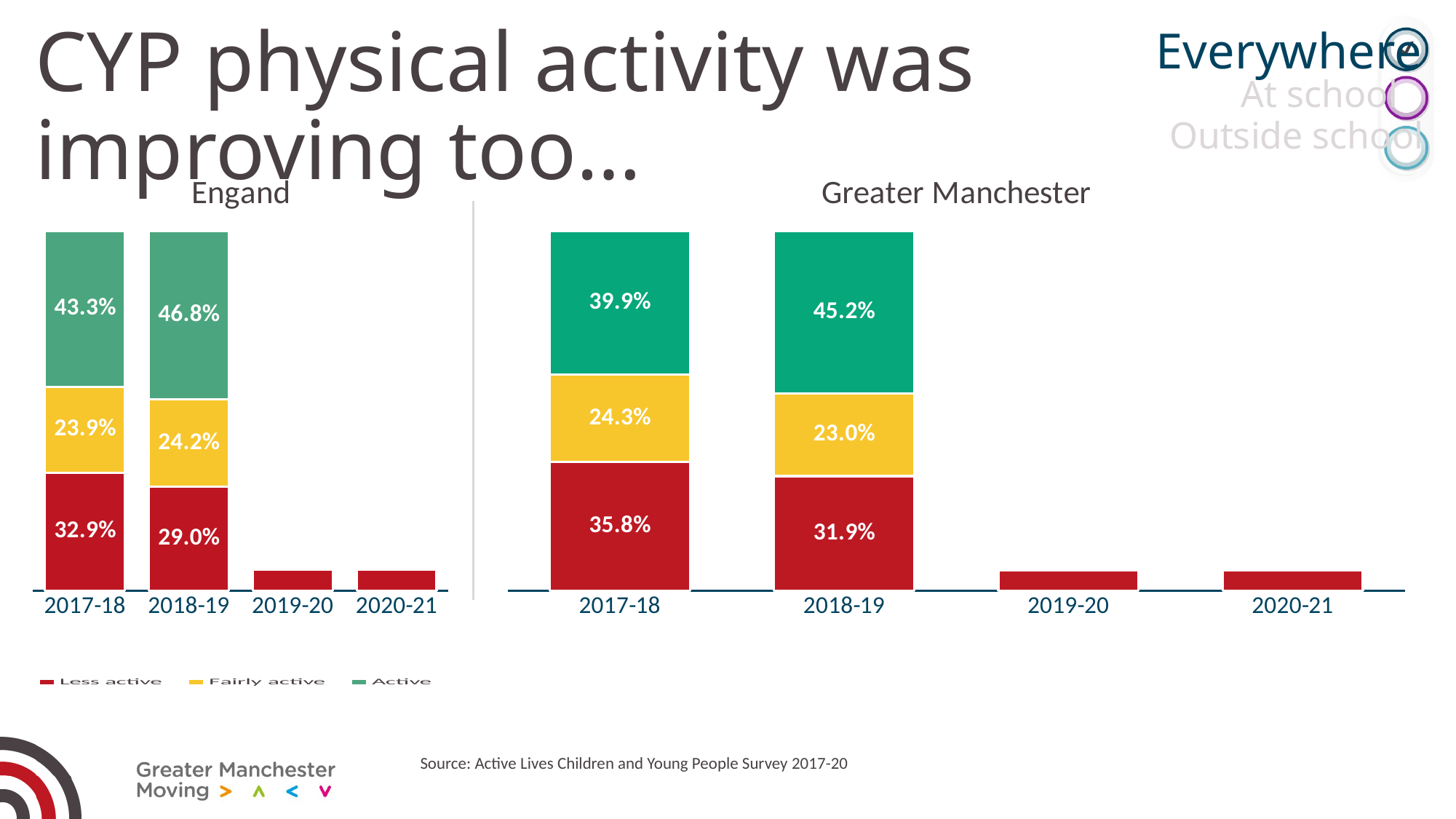
In the Engand chart, which year has the higher Fairly active value, 2017-18 or 2018-19? 2018-19 In the Greater Manchester chart, which is larger: the Active value for 2017-18 or for 2018-19? 2018-19 In the Greater Manchester chart, what is the Fairly active value for 2018-19? 23.0% In the Greater Manchester chart, what is the Less active value for 2017-18? 35.8% In the Engand chart, what is the difference between the Less active values for 2017-18 and 2018-19? 3.9% What kind of chart is used for the Engand data? Stacked bar chart Which colour represents the Less active series in the legend? Red In the Greater Manchester chart, by how much did the Active value change from 2017-18 to 2018-19? 5.3% In the Engand chart, what is the Less active value for 2017-18? 32.9% How many year categories are shown on the x axis of the Greater Manchester chart? 4 How many series does the legend list? 3 In the Engand chart, what is the Active value for 2018-19? 46.8%